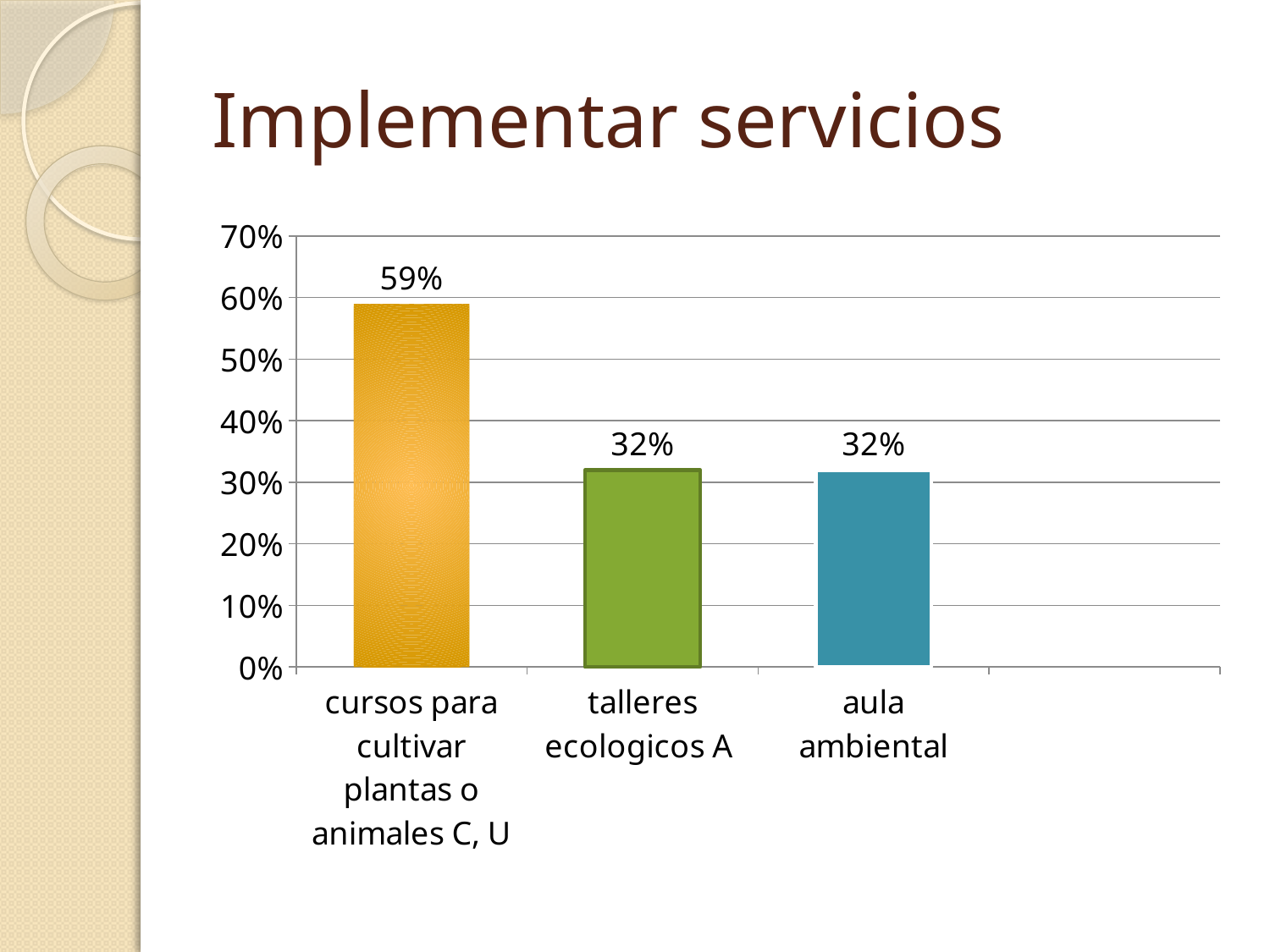
Which category has the highest value? cursos para cultivar plantas o animales C, U What is the difference between the value for "cursos para cultivar plantas o animales C, U" and the value for "talleres ecologicos A"? 27% How many categories are shown in the chart? 3 What is the highest value shown on the vertical axis? 70% What is the value for "cursos para cultivar plantas o animales C, U"? 59% What kind of chart is shown on the slide? bar chart What is the value for "aula ambiental"? 32% What is the value for "talleres ecologicos A"? 32% Is the value for "cursos para cultivar plantas o animales C, U" greater or less than 50%? greater Which is larger, the value for "cursos para cultivar plantas o animales C, U" or the value for "aula ambiental"? cursos para cultivar plantas o animales C, U Is the value for "talleres ecologicos A" greater or less than 40%? less What is the title of the slide? Implementar servicios